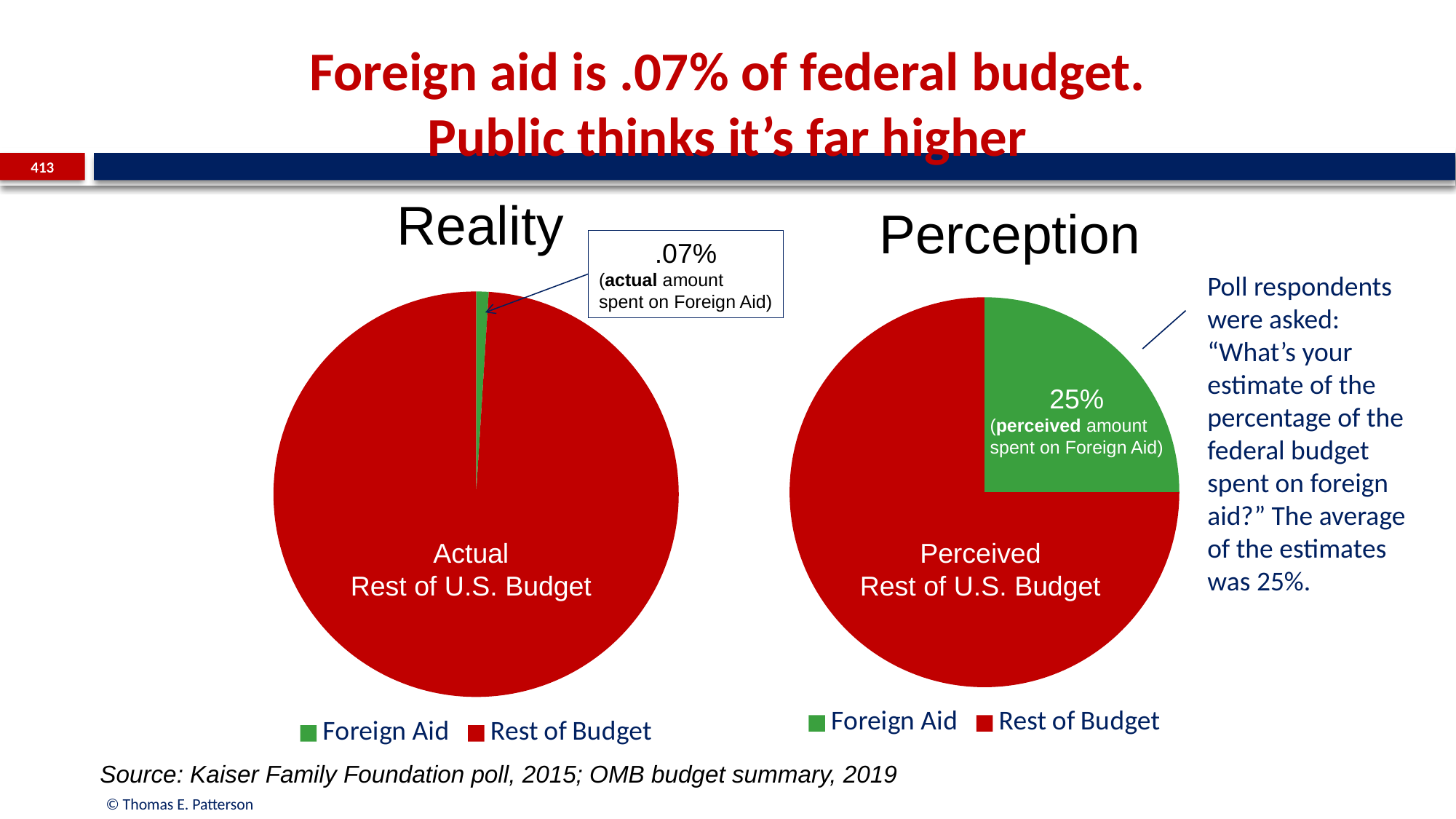
In the Perception pie chart, what value is labelled for the Foreign Aid slice? 25% In the Perception pie chart, which slice is the smallest? Foreign Aid How many slices does the Perception pie chart have? 2 How many entries does the legend of the Reality chart list? 2 What colour is used for the Foreign Aid slice in both pie charts? Green In the Reality pie chart, which slice is the largest? Rest of Budget Which chart shows a larger Foreign Aid slice, Reality or Perception? Perception In the Perception pie chart, what share of the pie does the Foreign Aid slice represent? 25% In the Reality pie chart, what value is labelled for the Foreign Aid slice? .07% What kind of chart is the Reality chart? Pie chart What are the titles of the two pie charts on the slide? Reality and Perception What is the difference between the perceived Foreign Aid share (Perception chart) and the actual Foreign Aid share (Reality chart)? 24.93%